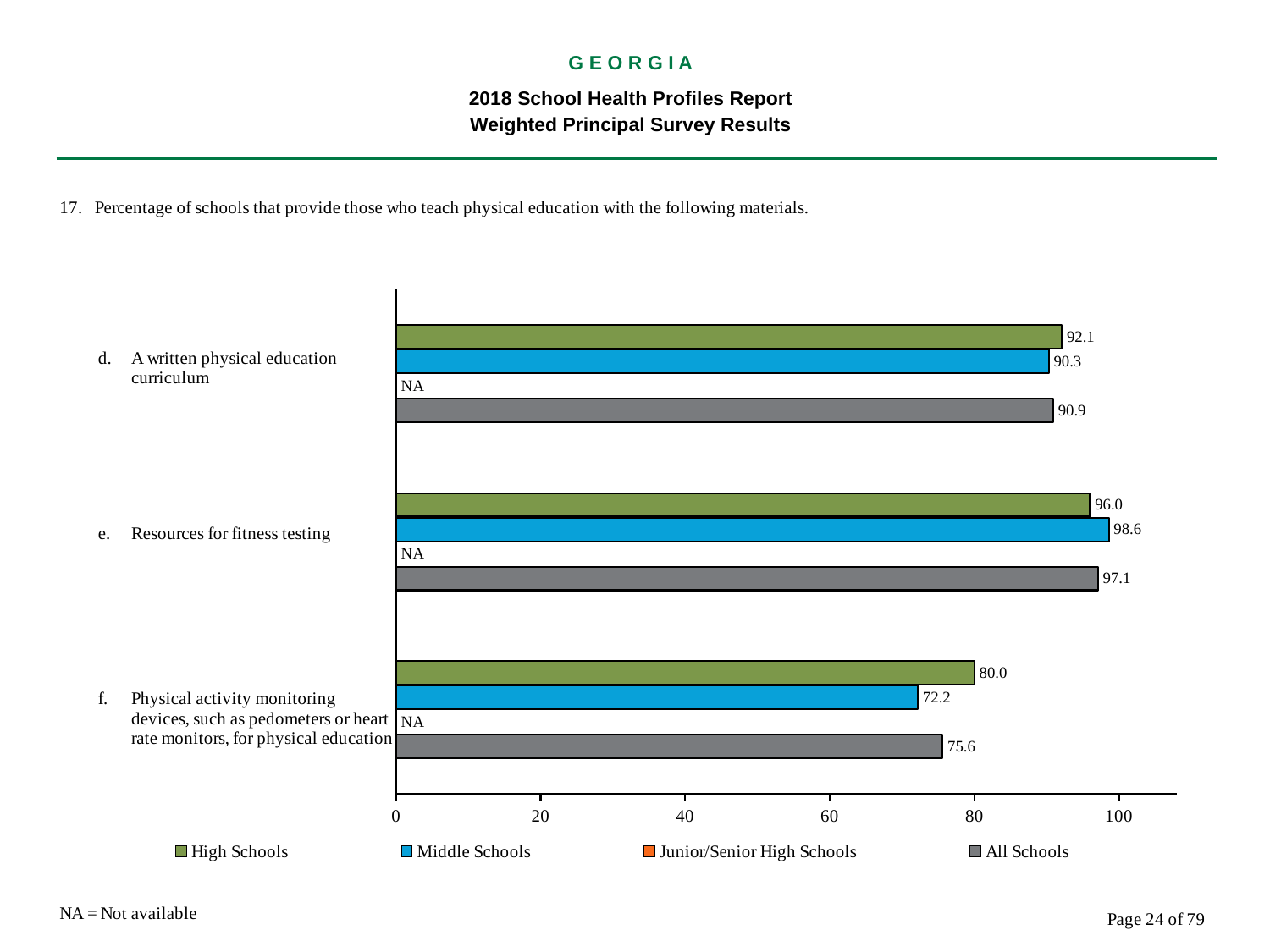
Which category has the lowest value for Middle Schools? Physical activity monitoring devices, such as pedometers or heart rate monitors, for physical education Which is larger for 'Resources for fitness testing': the High Schools value or the Middle Schools value? Middle Schools How many categories are shown on the chart? 3 What is the value for Middle Schools for 'Resources for fitness testing'? 98.6 What is the value for Middle Schools for 'Physical activity monitoring devices, such as pedometers or heart rate monitors, for physical education'? 72.2 How many series does the legend list? 4 What value is shown for Junior/Senior High Schools for 'Resources for fitness testing'? NA What is the value for High Schools for 'A written physical education curriculum'? 92.1 What is the difference between the High Schools and Middle Schools values for 'Physical activity monitoring devices, such as pedometers or heart rate monitors, for physical education'? 7.8 Which category has the highest value for High Schools? Resources for fitness testing What is the value for All Schools for 'Physical activity monitoring devices, such as pedometers or heart rate monitors, for physical education'? 75.6 What kind of chart is shown on the slide? Bar chart